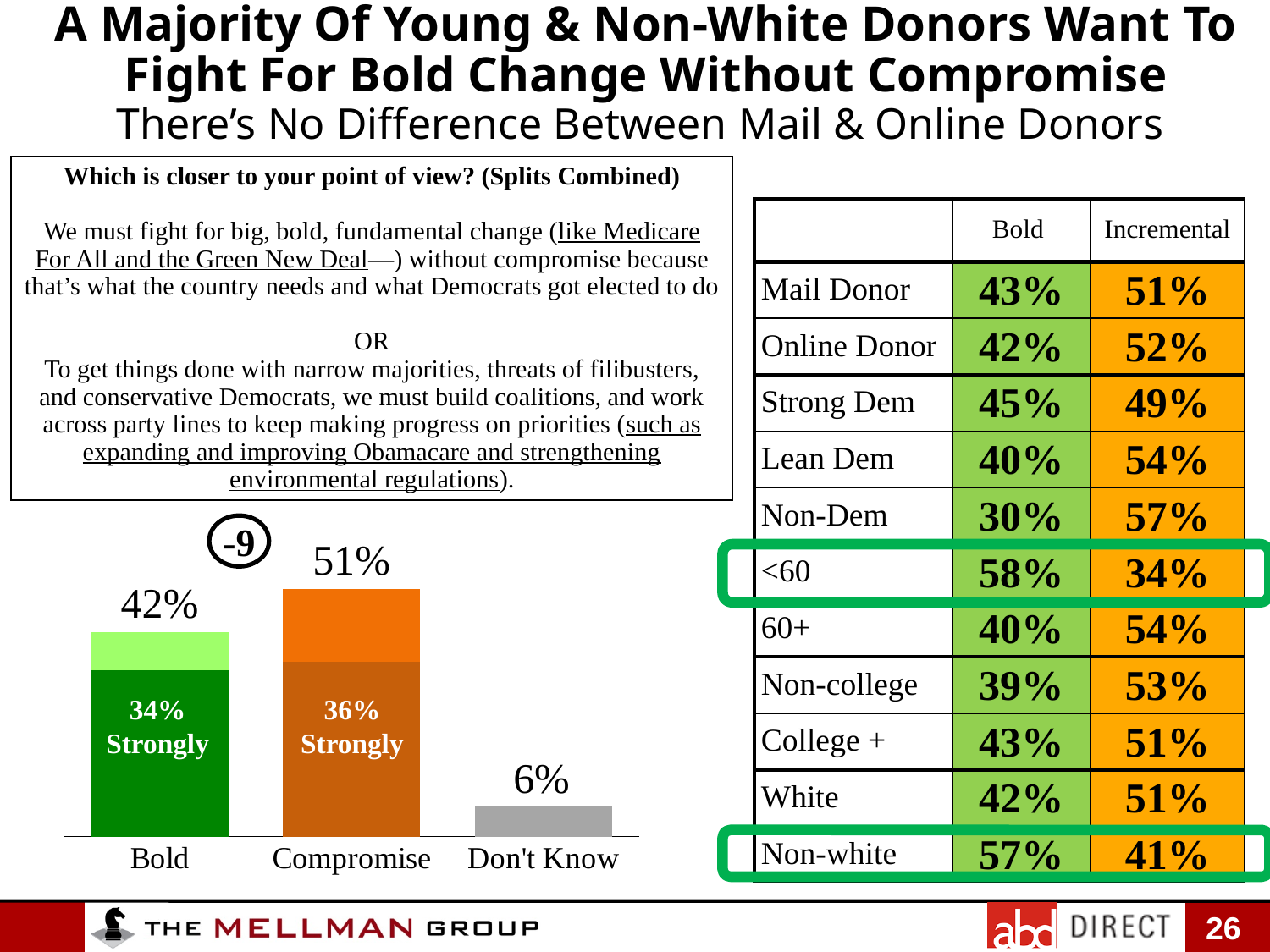
Which category has the highest value on the bar chart? Compromise Which is larger, the Bold total or the Compromise total? Compromise What share of respondents are labelled as 'Strongly' within the Compromise bar? 36% What is the difference between the Compromise total and the Bold total? 9 percentage points Which category has the lowest value on the bar chart? Don't Know What is the total value shown for the Compromise bar? 51% What is the total value shown for the Bold bar? 42% What is the value shown for the Don't Know bar? 6% What share of respondents are labelled as 'Strongly' within the Bold bar? 34% What number is shown in the circle above the Bold bar? -9 What kind of chart is shown on the slide? bar chart How many categories are shown on the bar chart? 3